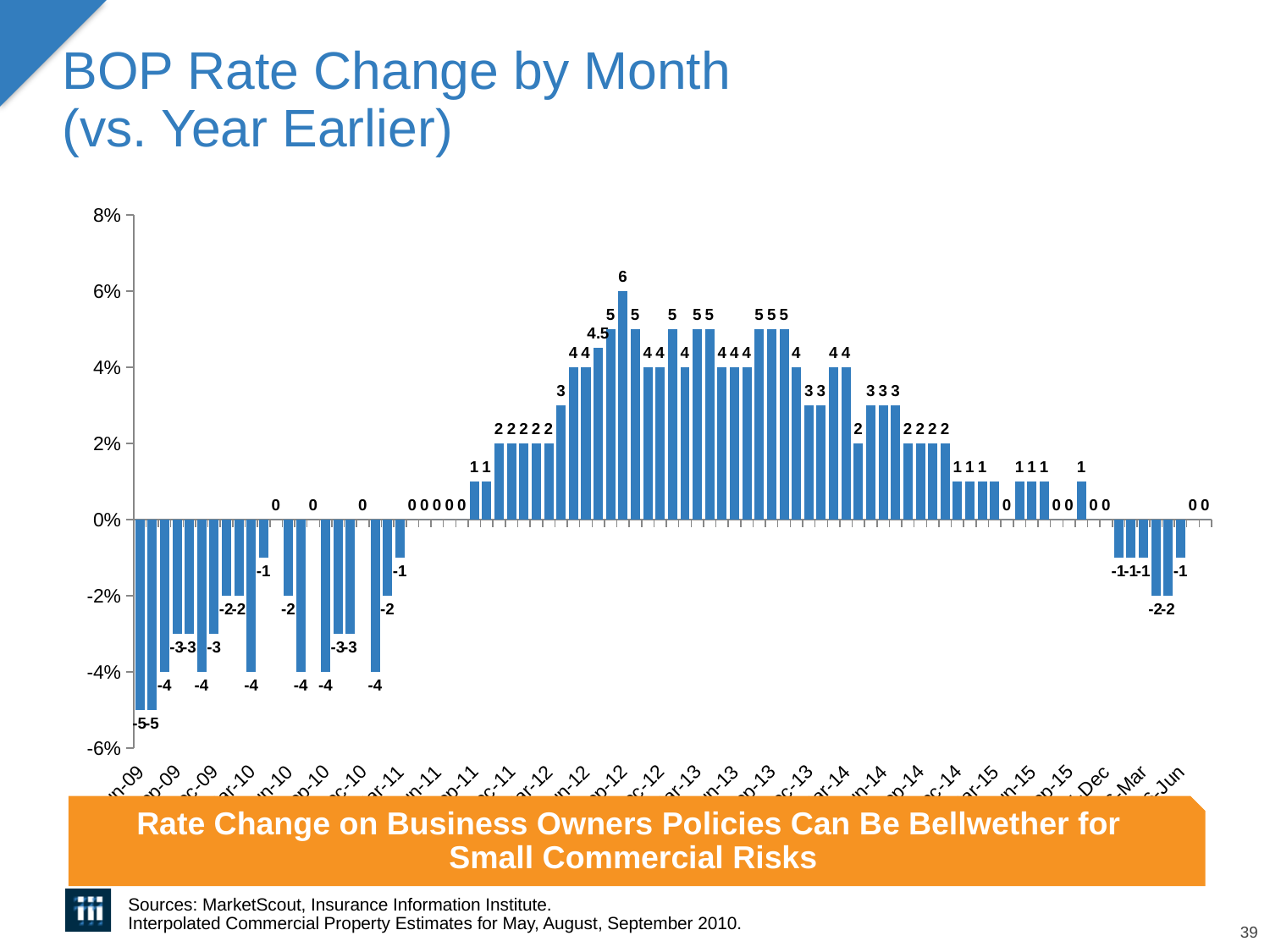
What is the difference between the highest labeled bar value (6) and the lowest labeled bar value (-5)? 11 Do the bar values rise or fall from the leftmost bar to the tallest bar in the chart? Rise What kind of chart is shown on the slide? Bar chart What is the highest value labeled on any bar in the chart? 6 How many data series are plotted in the chart? 1 Is the tallest bar in the chart greater or less than 4%? greater What is the highest tick shown on the vertical axis? 8% What is the only non-whole-number value labeled on a bar in the chart? 4.5 Which is larger: the tallest bar labeled 6 or the bar labeled 4.5? The bar labeled 6 What is the title of the chart on the slide? BOP Rate Change by Month (vs. Year Earlier) What is the lowest value labeled on any bar in the chart? -5 Are the leftmost bars in the chart greater or less than -4%? less